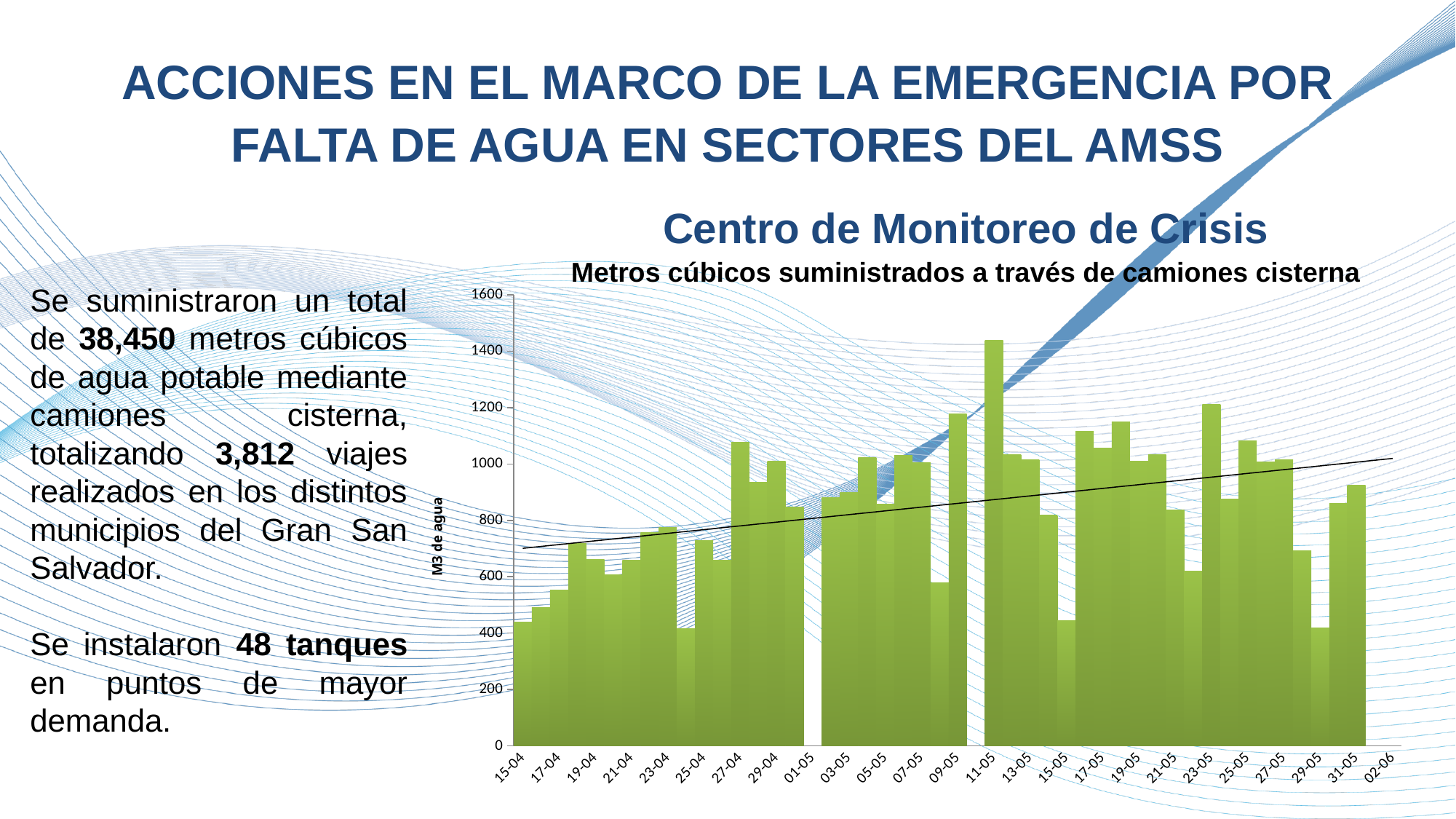
Is the value for 11-05 greater or less than 1200? greater Does the trend line drawn across the chart rise or fall from left to right? rise Is the value for 09-05 greater or less than 1000? greater What is the label on the vertical axis of the chart? M3 de agua Is the value for 15-04 greater or less than 600? less Which is larger, the value for 27-04 or the value for 25-04? 27-04 What kind of chart is shown under 'Metros cúbicos suministrados a través de camiones cisterna'? bar chart Which date has the highest value in the chart? 11-05 Which is larger, the value for 11-05 or the value for 15-04? 11-05